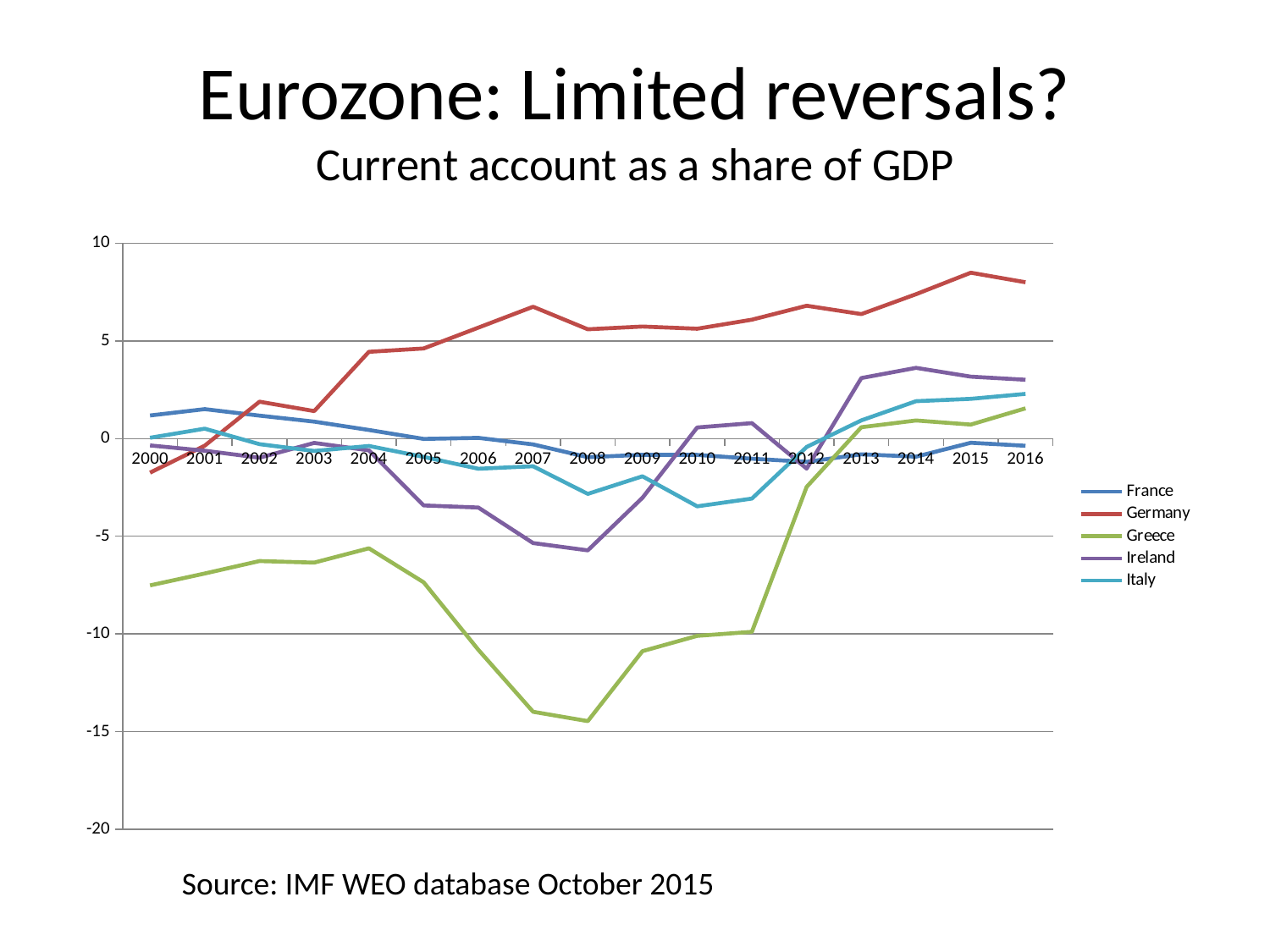
Which country has the lowest value in 2000? Greece How many years are plotted along the x axis? 17 Is the value for Ireland in 2005 greater or less than -5? greater Which country has the highest value in 2016? Germany Is the value for Germany in 2015 greater or less than 5? greater In 2014, which is higher, Ireland or Italy? Ireland Is the value for Greece in 2008 greater or less than -10? less Which country has the lowest value in 2008? Greece How many series does the legend list? 5 What is the subtitle describing what the chart measures? Current account as a share of GDP Does the value for Greece rise or fall from 2008 to 2016? rise What kind of chart is shown on the slide? line chart